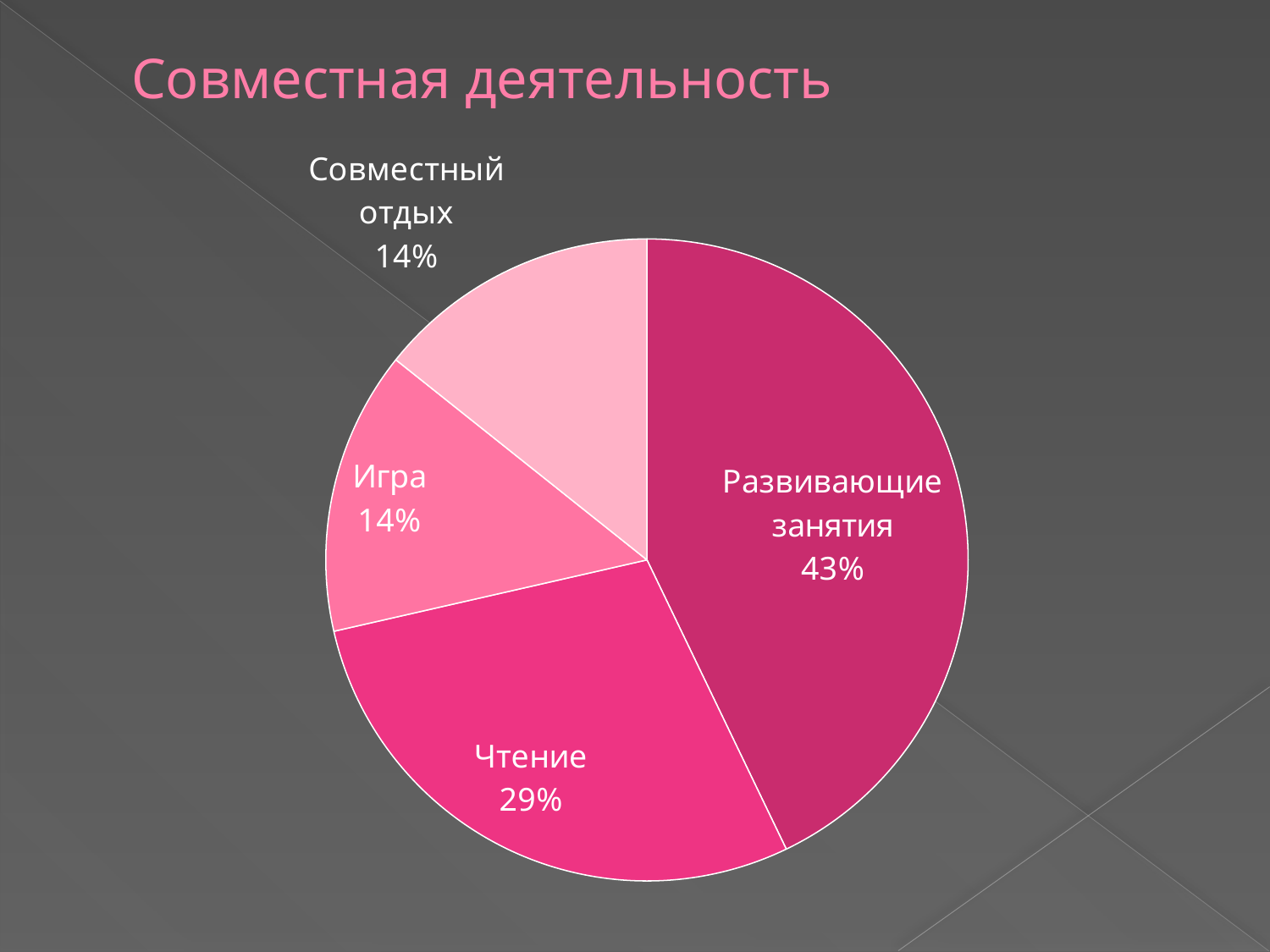
What kind of chart is shown on the slide? Pie chart What is the difference in percentage points between Чтение and Игра? 15 What share of the pie does Чтение take? 29% Which is larger, the slice for Чтение or the slice for Игра? Чтение What is the difference in percentage points between Развивающие занятия and Чтение? 14 What is the title of the slide? Совместная деятельность Which category has the largest slice of the pie? Развивающие занятия How many slices does the pie chart have? 4 What share of the pie does Игра take? 14% Which is larger, the slice for Развивающие занятия or the slice for Совместный отдых? Развивающие занятия What share of the pie does Развивающие занятия take? 43%